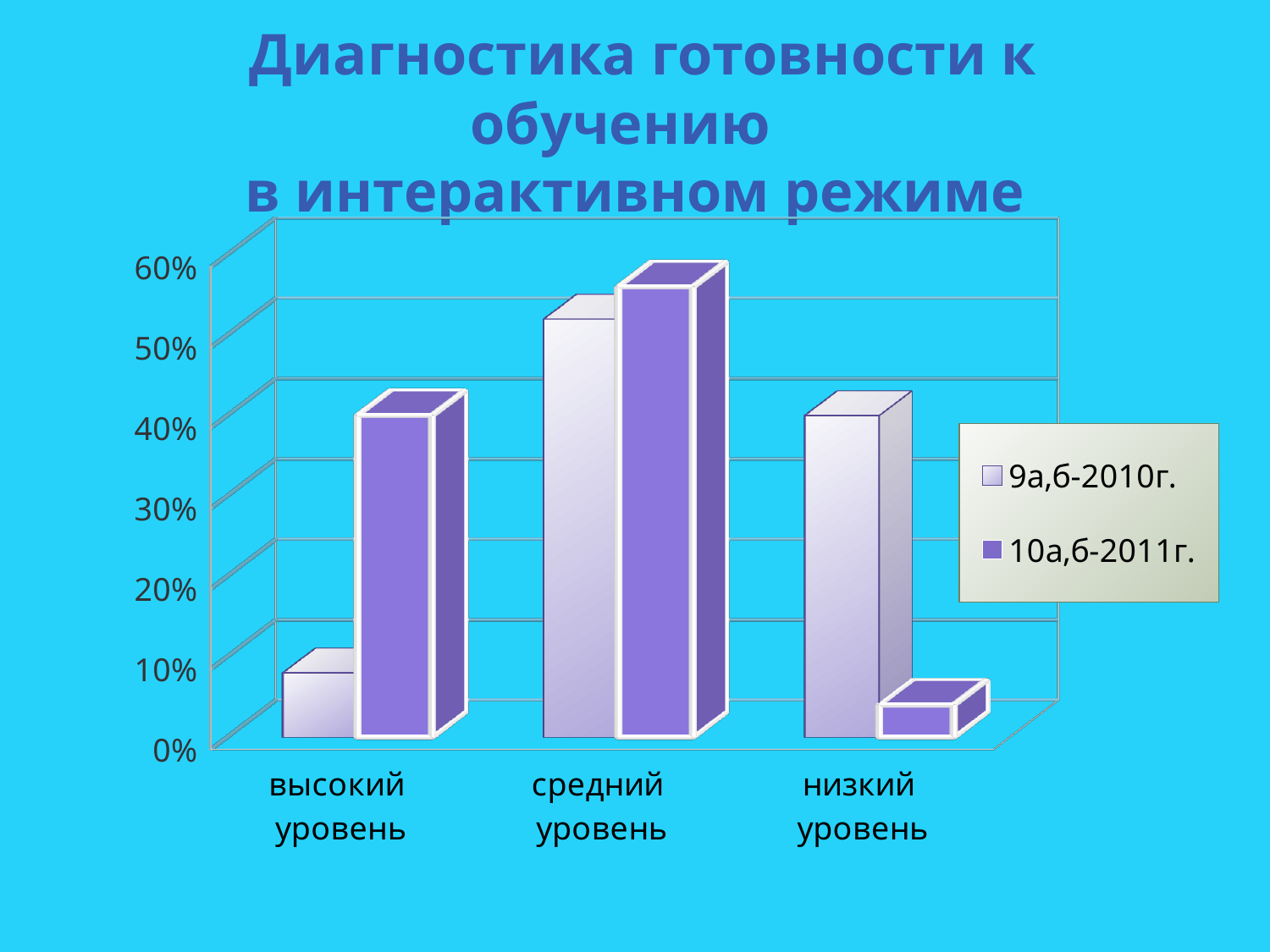
For высокий уровень, which series has the larger value, 9а,б-2010г. or 10а,б-2011г.? 10а,б-2011г. Which category has the highest value for the series 9а,б-2010г.? средний уровень How many categories are shown on the x axis? 3 Is the value for высокий уровень in the series 9а,б-2010г. greater or less than 20%? less For низкий уровень, which series has the larger value, 9а,б-2010г. or 10а,б-2011г.? 9а,б-2010г. Which category has the highest value for the series 10а,б-2011г.? средний уровень What kind of chart is shown on the slide? bar chart Which category has the lowest value for the series 10а,б-2011г.? низкий уровень Is the value for низкий уровень in the series 10а,б-2011г. greater or less than 10%? less How many series does the legend list? 2 Which category has the lowest value for the series 9а,б-2010г.? высокий уровень What are the two entries listed in the legend? 9а,б-2010г. and 10а,б-2011г.